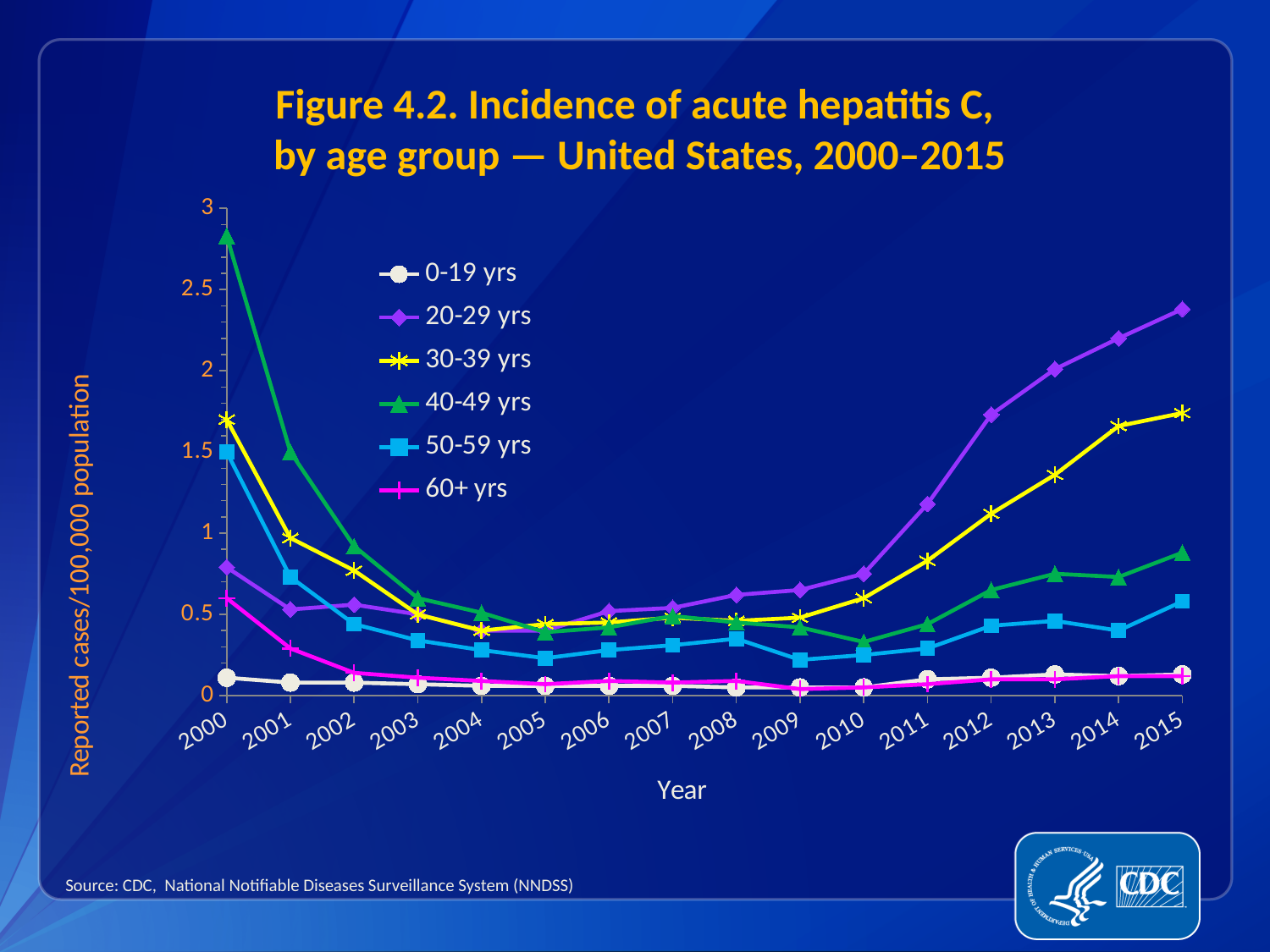
What kind of chart is shown on the slide? line chart What is the label of the y axis? Reported cases/100,000 population Is the value for 40-49 yrs in 2000 greater or less than 2.5? greater Is the value for 20-29 yrs in 2015 greater or less than 2? greater How many age groups does the legend list? 6 Is the value for 30-39 yrs in 2015 greater or less than 2? less In 2015, which is larger: the value for 30-39 yrs or the value for 40-49 yrs? 30-39 yrs Which age group had the highest incidence in 2000? 40-49 yrs Does the incidence for 20-29 yrs rise or fall from 2010 to 2015? rise Which age group had the highest incidence in 2015? 20-29 yrs How many years are plotted along the x axis? 16 Which age group had the lowest incidence in 2000? 0-19 yrs